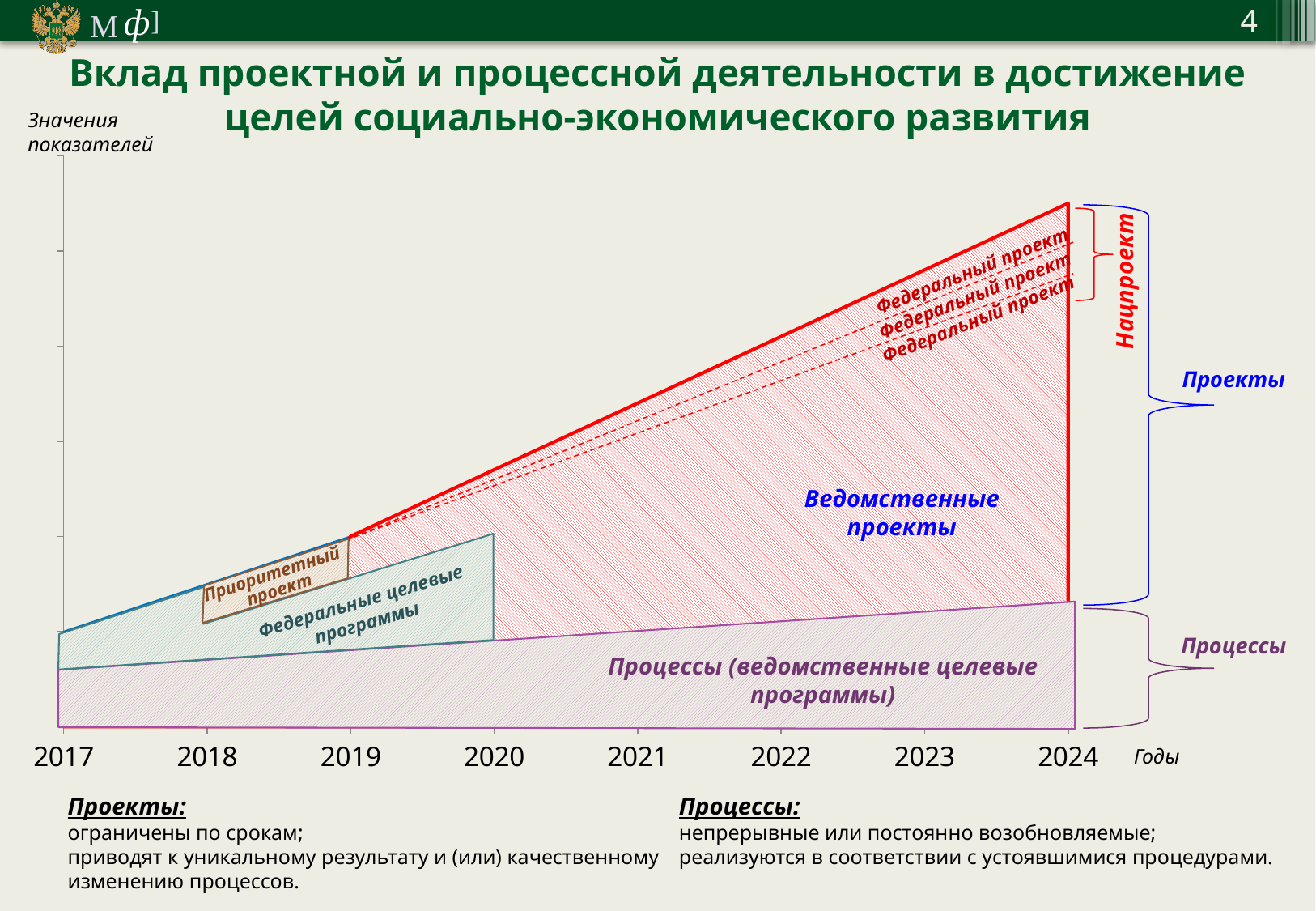
In which year does the blue area labelled 'Федеральные целевые программы' end? 2020 How many year labels are shown along the x axis? 8 What is the label of the x axis? Годы What is the first year shown on the x axis? 2017 What is the title of the chart on the slide? Вклад проектной и процессной деятельности в достижение целей социально-экономического развития Does the red hatched area (Ведомственные проекты / Федеральный проект) rise or fall from 2019 to 2024? rise What is the last year shown on the x axis? 2024 Which of the two bracketed groups on the right, 'Проекты' or 'Процессы', covers the larger vertical range at 2024? Проекты How many 'Федеральный проект' labels are shown inside the red area? 3 In which year does the red hatched area labelled 'Ведомственные проекты' begin? 2019 What is the label of the y axis? Значения показателей Which area spans the full x axis from 2017 to 2024? Процессы (ведомственные целевые программы)